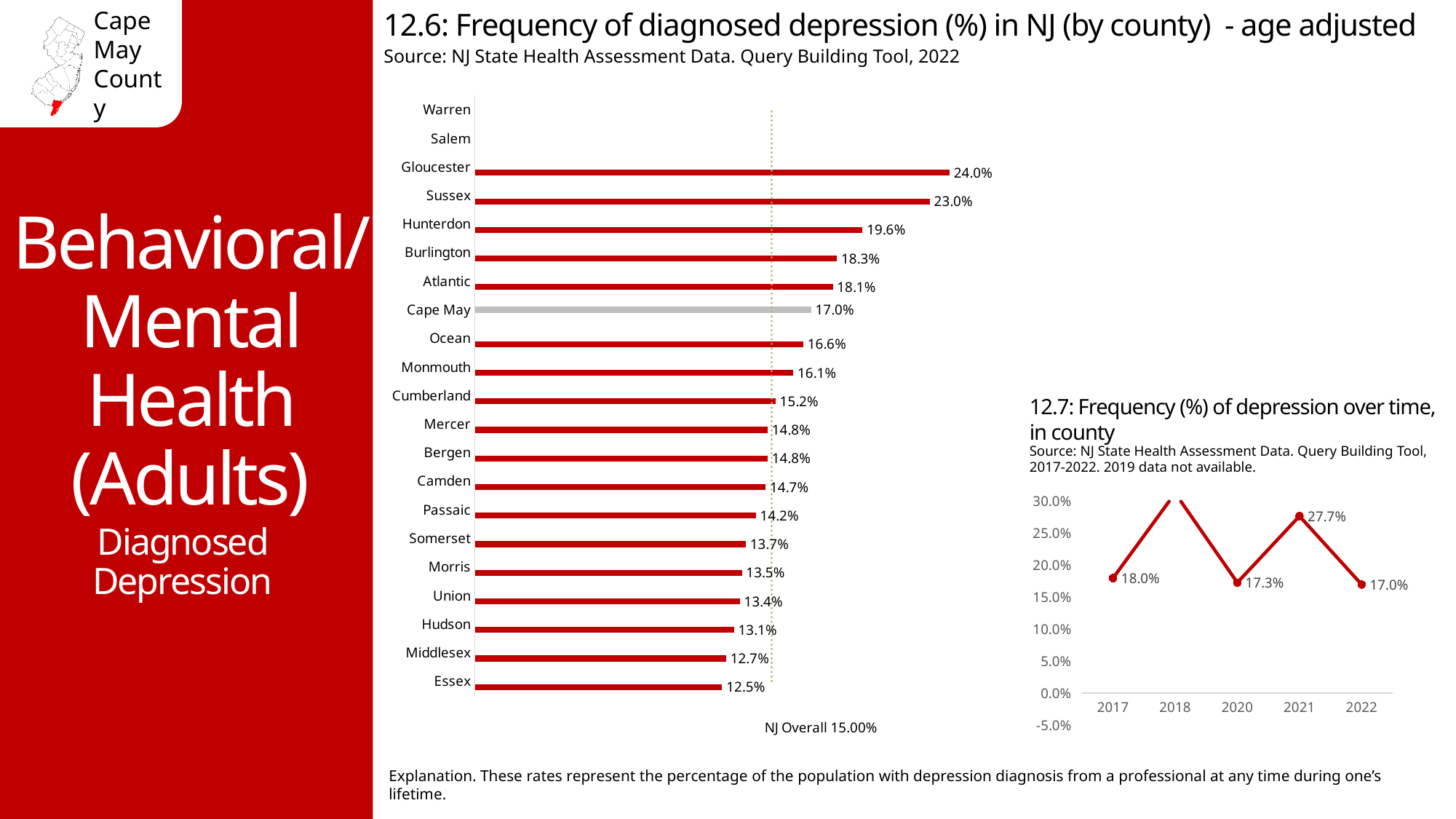
In chart 12.6, what is the difference between the values for Gloucester and Sussex? 1.0% In chart 12.6, which county has a higher value, Burlington or Ocean? Burlington In chart 12.7, is the value for 2018 greater or less than 25.0%? greater In chart 12.6, what NJ Overall value is shown? 15.00% What kind of chart is chart 12.6? Bar chart In chart 12.7, what is the difference between the values for 2021 and 2022? 10.7% In chart 12.6, what is the frequency of diagnosed depression for Gloucester county? 24.0% In chart 12.7, what is the frequency of depression in 2021? 27.7% In chart 12.6, which county with a plotted bar has the lowest frequency of diagnosed depression? Essex In chart 12.6, what is the value shown for Cape May? 17.0% In chart 12.6, which county has the highest frequency of diagnosed depression? Gloucester In chart 12.7, how many years are plotted on the x axis? 5